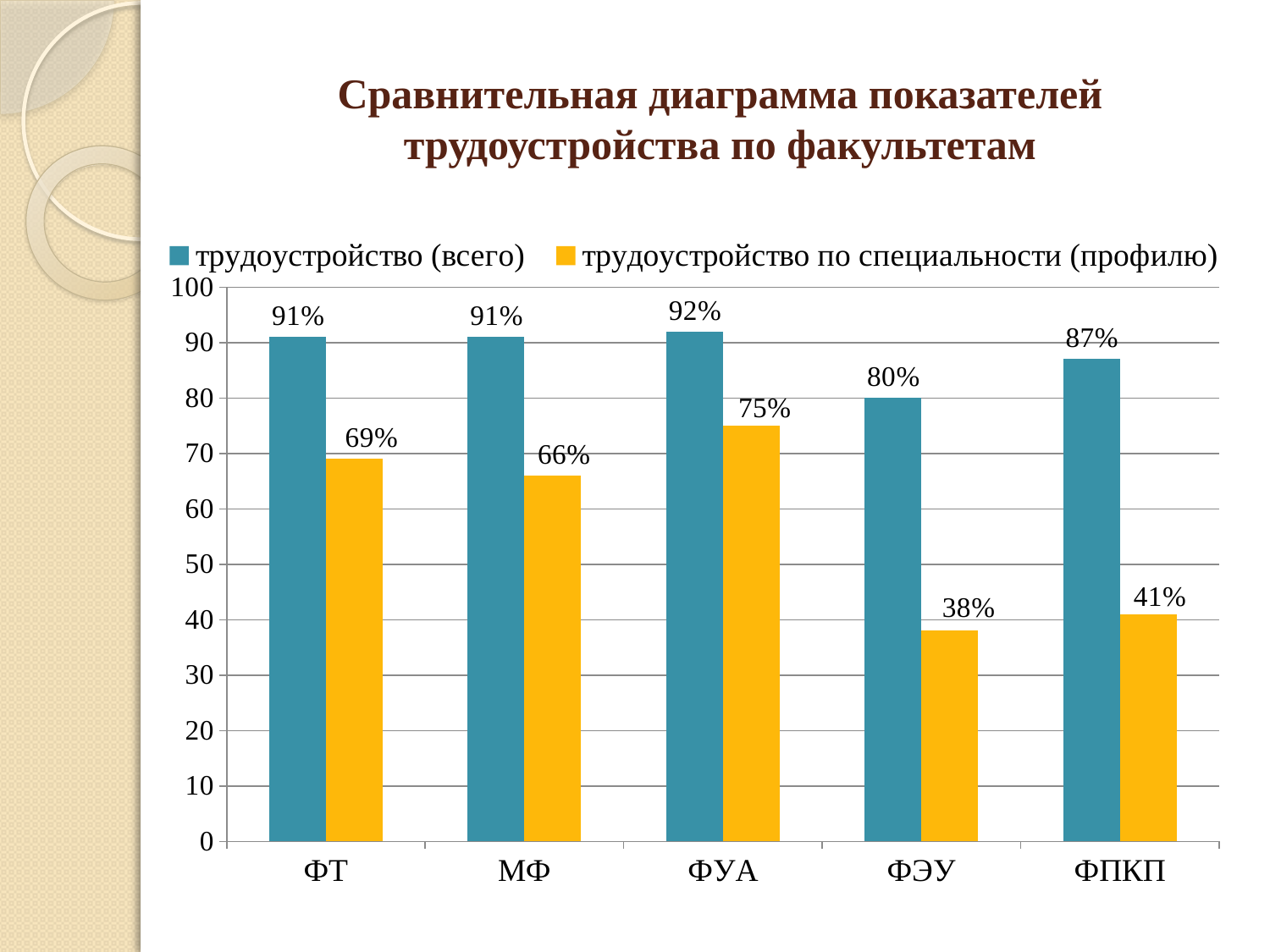
Which faculty has the lowest value for трудоустройство по специальности (профилю)? ФЭУ What kind of chart is shown on the slide? bar chart Which is larger: трудоустройство по специальности (профилю) for ФТ or for МФ? ФТ What is the value of трудоустройство по специальности (профилю) for ФПКП? 41% How many faculties are shown on the x axis? 5 Which faculty has the highest value for трудоустройство (всего)? ФУА What is the difference between трудоустройство (всего) and трудоустройство по специальности (профилю) for ФЭУ? 42% What is the value of трудоустройство по специальности (профилю) for ФУА? 75% What is the value of трудоустройство (всего) for ФЭУ? 80% Is the value of трудоустройство по специальности (профилю) for ФЭУ greater or less than 40? less How many series does the legend list? 2 What colour are the bars for трудоустройство по специальности (профилю)? yellow